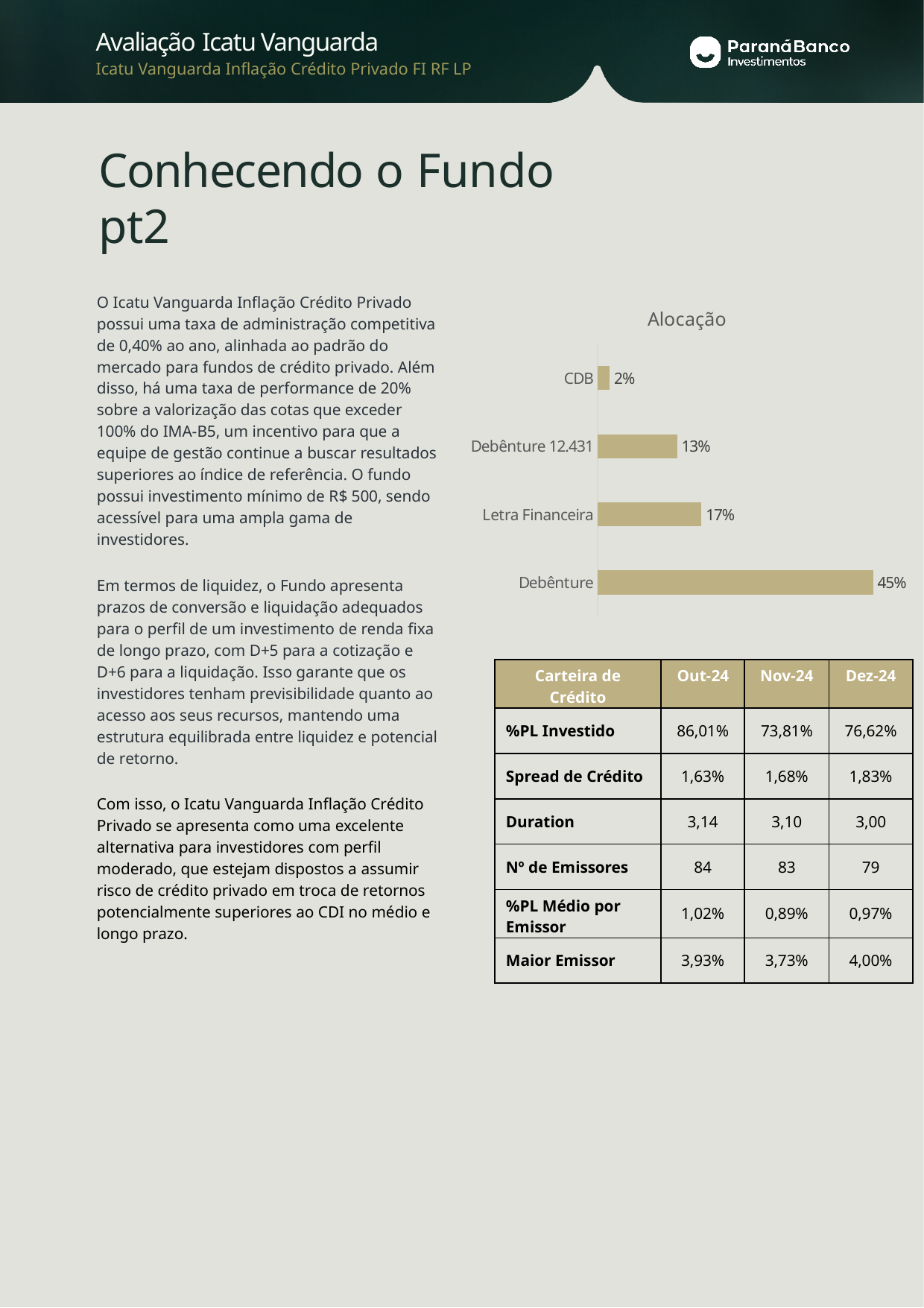
What is the value for Debênture 12.431 in the Alocação chart? 13% What is the value for Debênture in the Alocação chart? 45% What is the value for CDB in the Alocação chart? 2% How many categories are shown in the Alocação chart? 4 What kind of chart is the Alocação chart? Bar chart What is the value for Letra Financeira in the Alocação chart? 17% What is the difference between the values for Letra Financeira and Debênture 12.431 in the Alocação chart? 4% Which category has the highest value in the Alocação chart? Debênture What is the title of the chart on the slide? Alocação What is the difference between the values for Debênture and Letra Financeira in the Alocação chart? 28% Which is larger in the Alocação chart, Letra Financeira or Debênture 12.431? Letra Financeira Which category has the lowest value in the Alocação chart? CDB